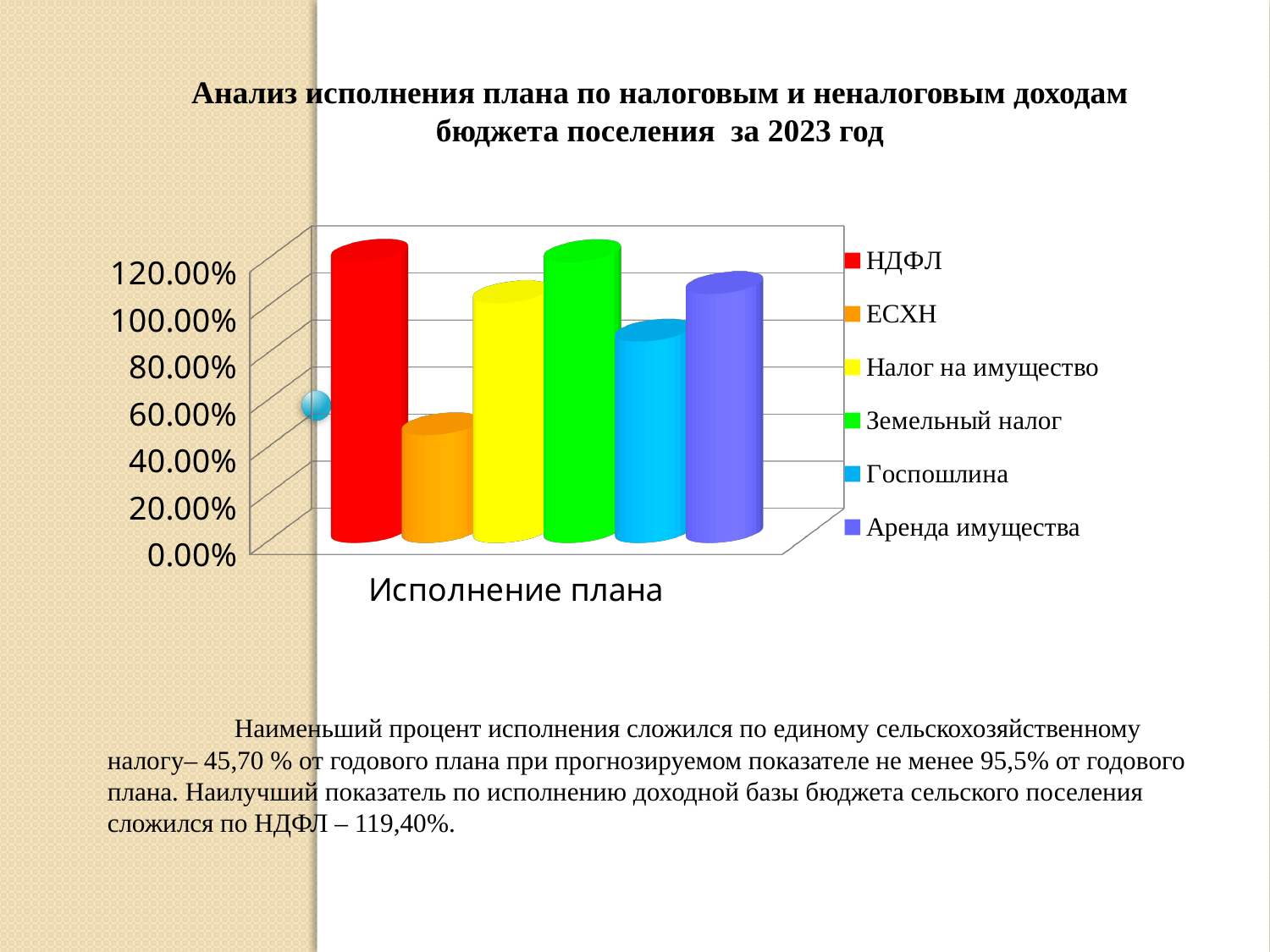
How many bars are plotted in the chart? 6 Which series has the lowest value in the chart? ЕСХН What is the category label shown under the bars on the x axis? Исполнение плана How many series does the chart legend list? 6 What kind of chart is shown on the slide? Bar chart Is the value for Госпошлина greater or less than 100.00%? less Which is larger, the value for Госпошлина or the value for Аренда имущества? Аренда имущества Which is larger, the value for НДФЛ or the value for ЕСХН? НДФЛ What colour is the bar for ЕСХН? Orange Is the value for Аренда имущества greater or less than 80.00%? greater Is the value for Земельный налог greater or less than 100.00%? greater